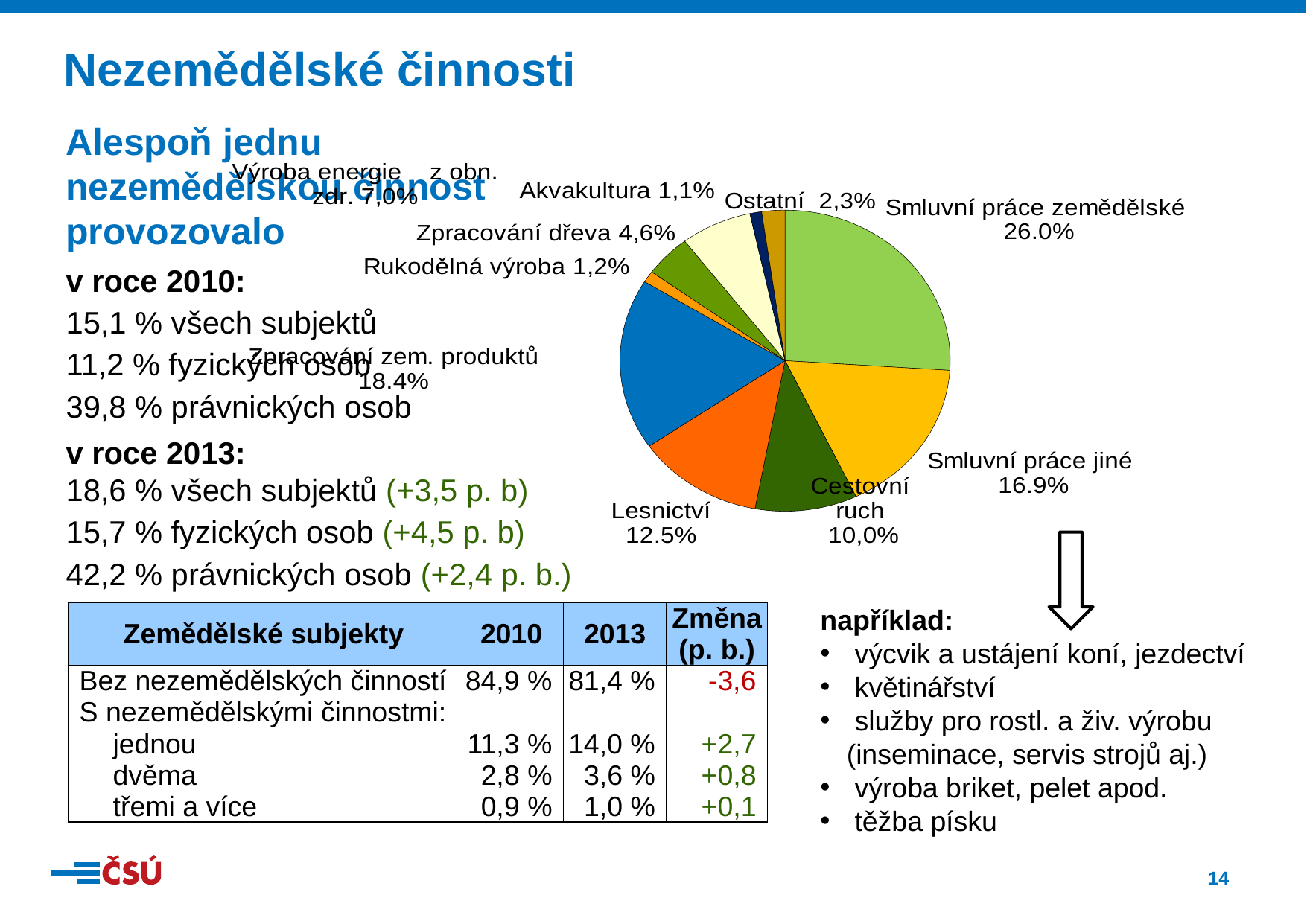
What share of the pie chart does Cestovní ruch have? 10,0% What share of the pie chart does Ostatní have? 2,3% Which slice of the pie chart is the largest? Smluvní práce zemědělské Which is larger in the pie chart, Smluvní práce jiné or Zpracování zem. produktů? Zpracování zem. produktů What share of the pie chart does Akvakultura have? 1,1% Which slice of the pie chart is the smallest? Akvakultura What is the difference in percentage points between Smluvní práce zemědělské and Smluvní práce jiné in the pie chart? 9.1 How many slices does the pie chart have? 10 What kind of chart is shown on the slide? pie chart What share of the pie chart does Zpracování dřeva have? 4,6% What share of the pie chart does Smluvní práce zemědělské have? 26.0% What share of the pie chart does Lesnictví have? 12.5%